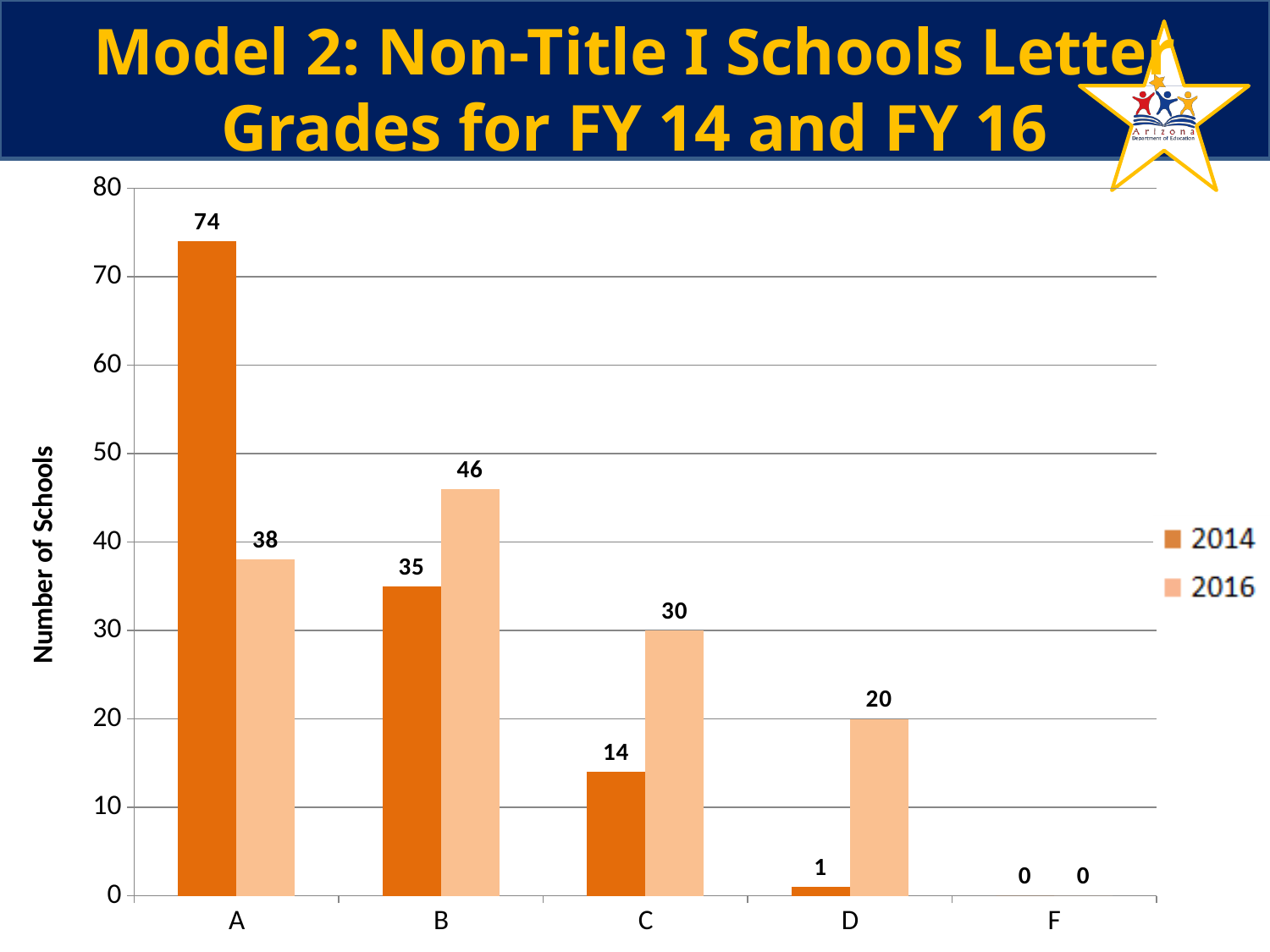
Which letter grade has the lowest number of schools for 2016? F For grade B, which year has more schools, 2014 or 2016? 2016 What is the difference between the 2016 and 2014 values for grade D? 19 How many letter grade categories are shown on the x axis? 5 How many series does the legend list? 2 How many Non-Title I schools received a D grade in 2014? 1 What type of chart is shown on the slide? Bar chart What is the difference between the 2014 and 2016 values for grade A? 36 Which letter grade has the highest number of schools for 2014? A How many Non-Title I schools received a C grade in 2016? 30 How many Non-Title I schools received an A grade in 2014? 74 What is the label of the vertical axis? Number of Schools